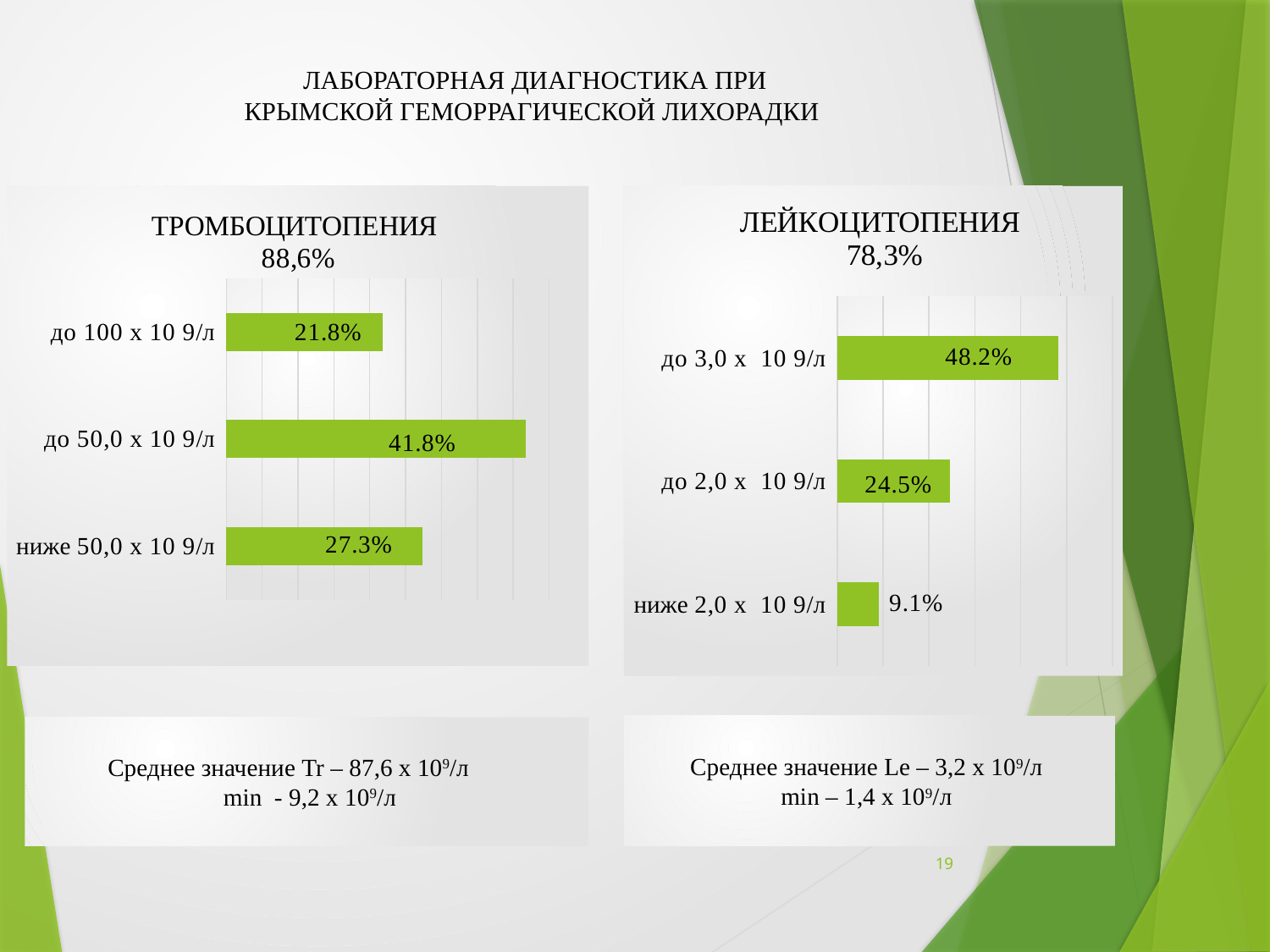
In the ЛЕЙКОЦИТОПЕНИЯ chart, what is the value for ниже 2,0 х 10 9/л? 9.1% In the ТРОМБОЦИТОПЕНИЯ chart, what is the value for до 100 х 10 9/л? 21.8% In the ТРОМБОЦИТОПЕНИЯ chart, how many categories are shown? 3 In the ТРОМБОЦИТОПЕНИЯ chart, which category has the highest value? до 50,0 х 10 9/л In the ЛЕЙКОЦИТОПЕНИЯ chart, which category has the lowest value? ниже 2,0 х 10 9/л In the ТРОМБОЦИТОПЕНИЯ chart, what is the difference between the values for до 50,0 х 10 9/л and ниже 50,0 х 10 9/л? 14.5% In the ЛЕЙКОЦИТОПЕНИЯ chart, what is the value for до 3,0 х 10 9/л? 48.2% In the ТРОМБОЦИТОПЕНИЯ chart, which category has the lowest value? до 100 х 10 9/л What kind of chart is the ЛЕЙКОЦИТОПЕНИЯ chart? Bar chart In the ЛЕЙКОЦИТОПЕНИЯ chart, which is larger: the value for до 2,0 х 10 9/л or ниже 2,0 х 10 9/л? до 2,0 х 10 9/л In the ТРОМБОЦИТОПЕНИЯ chart, what is the value for до 50,0 х 10 9/л? 41.8% In the ЛЕЙКОЦИТОПЕНИЯ chart, what is the difference between the values for до 3,0 х 10 9/л and до 2,0 х 10 9/л? 23.7%